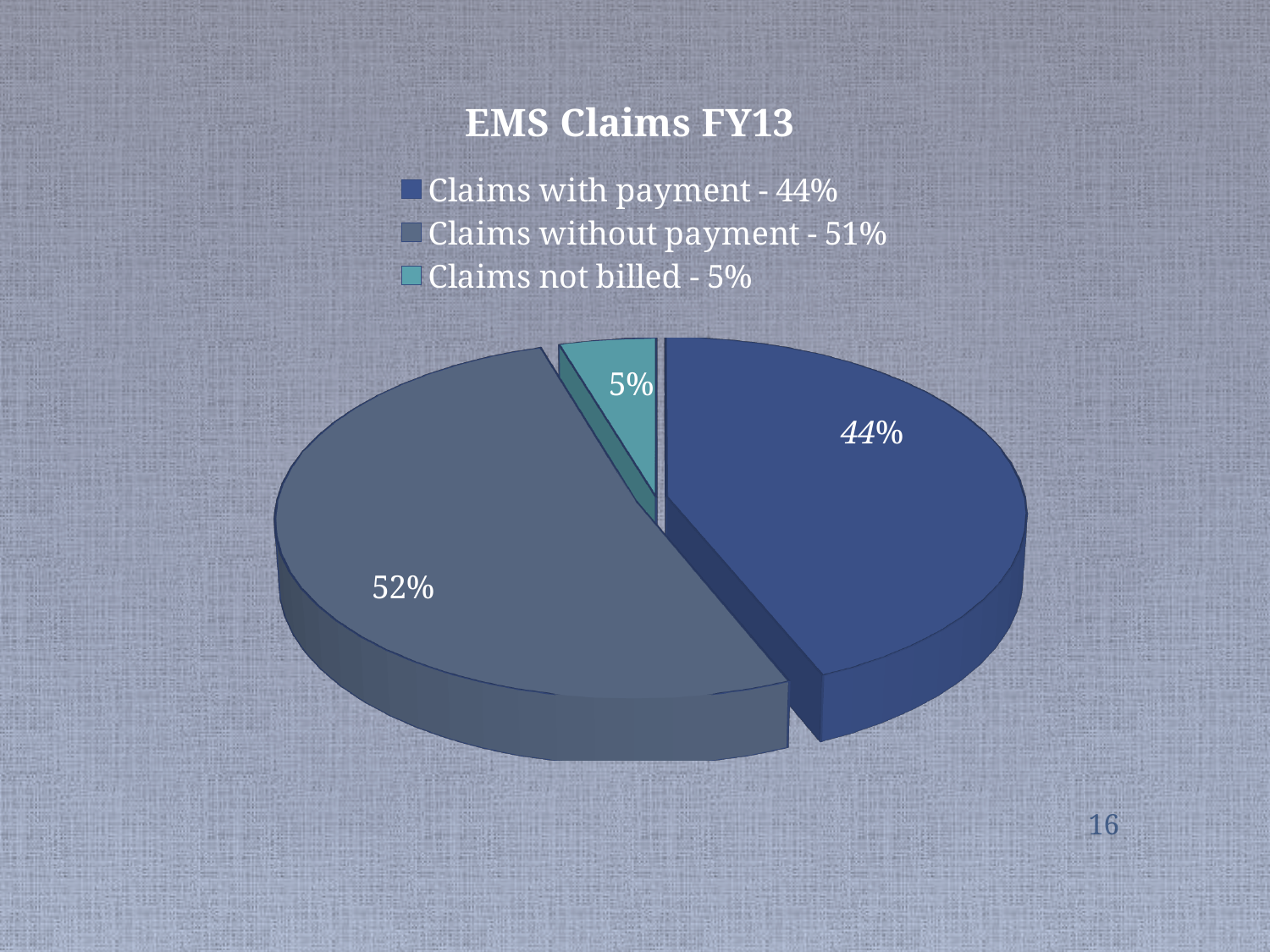
What percentage is printed on the slice for Claims not billed? 5% Which category has the largest slice of the pie? Claims without payment How many entries does the legend list? 3 What percentage is printed on the slice for Claims without payment? 52% What is the title of the pie chart? EMS Claims FY13 Which is larger, the slice for Claims with payment or the slice for Claims not billed? Claims with payment What percentage does the legend entry give for Claims without payment? 51% What is the difference between the percentages printed on the Claims with payment slice and the Claims not billed slice? 39% What kind of chart is shown on the slide? pie chart What percentage is printed on the slice for Claims with payment? 44% How many slices does the pie chart have? 3 Which category has the smallest slice of the pie? Claims not billed